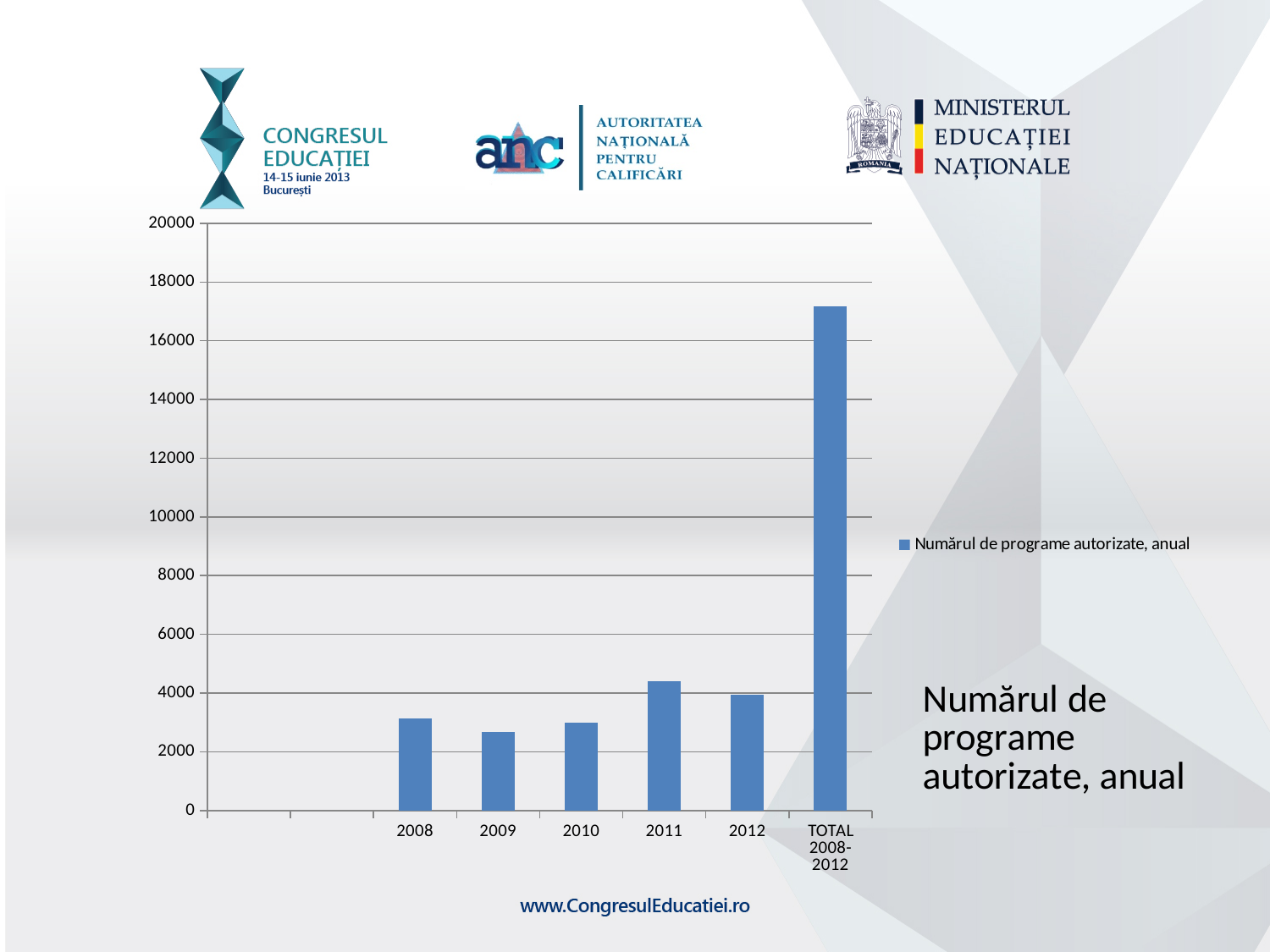
Is the value for TOTAL 2008-2012 greater or less than 16000? greater Which year has the lowest bar in the chart? 2009 Is the value for 2009 greater or less than 4000? less Is the value for 2011 greater or less than 4000? greater How many categories are shown on the x axis of the chart? 6 Which is larger, the value for 2008 or the value for 2009? 2008 Which is larger, the value for 2011 or the value for 2012? 2011 What kind of chart is shown on the slide? bar chart What is the legend entry of the chart? Numărul de programe autorizate, anual How many series does the chart's legend list? 1 Which category has the highest bar in the chart? TOTAL 2008-2012